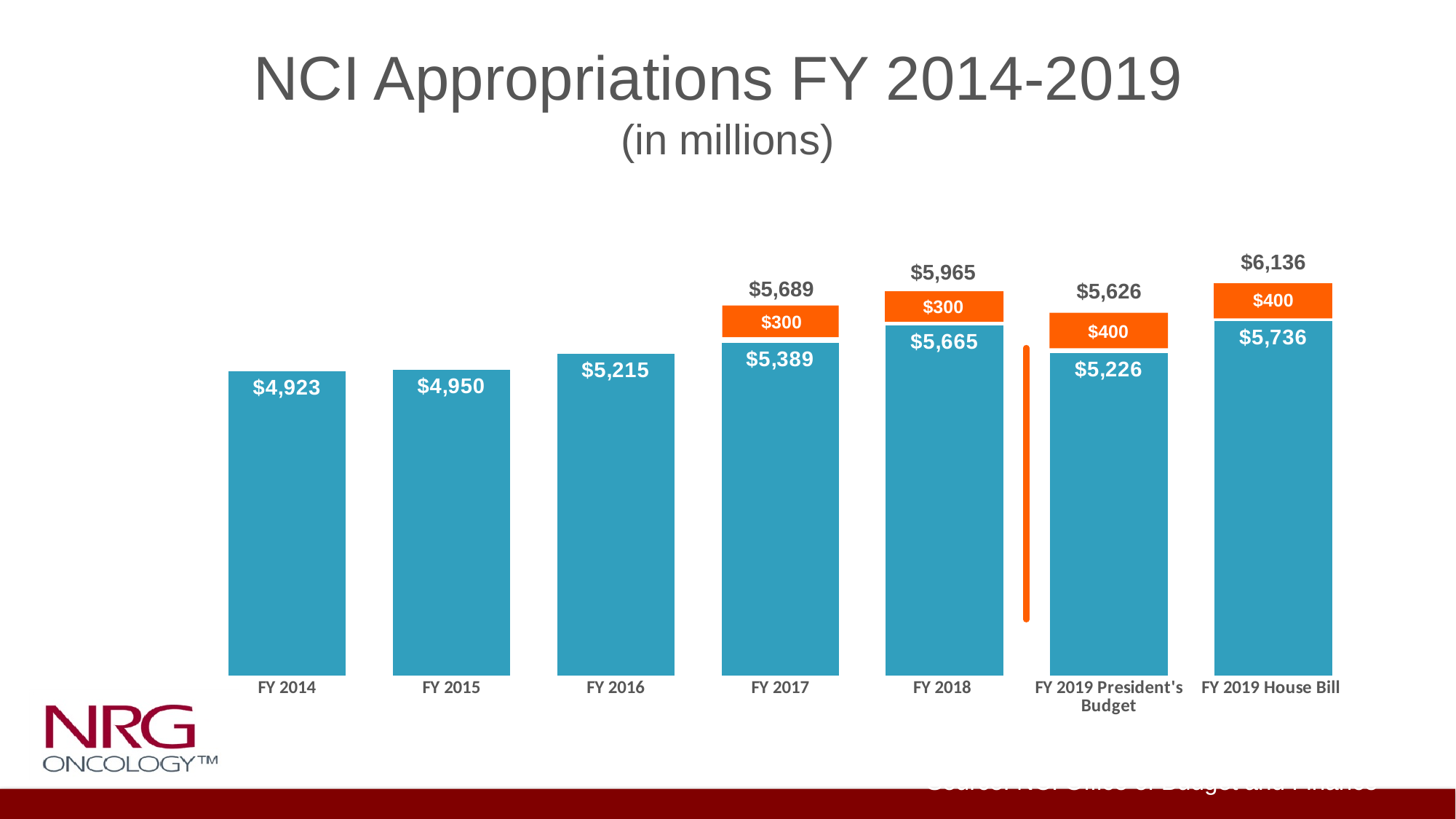
Which category has the highest total value? FY 2019 House Bill Which category has the lowest value? FY 2014 What is the value of the blue bar for FY 2016? $5,215 Which is larger, the blue bar for FY 2018 or the blue bar for FY 2019 President's Budget? FY 2018 What is the value of the blue bar for FY 2014? $4,923 What is the total shown above the FY 2018 bar? $5,965 What is the difference between the totals for FY 2019 House Bill and FY 2019 President's Budget? $510 How many categories are shown on the x axis? 7 What is the difference between the blue bar values for FY 2015 and FY 2014? $27 What is the orange segment value for FY 2017? $300 What is the total shown above the FY 2019 House Bill bar? $6,136 What kind of chart is shown on the slide? Bar chart